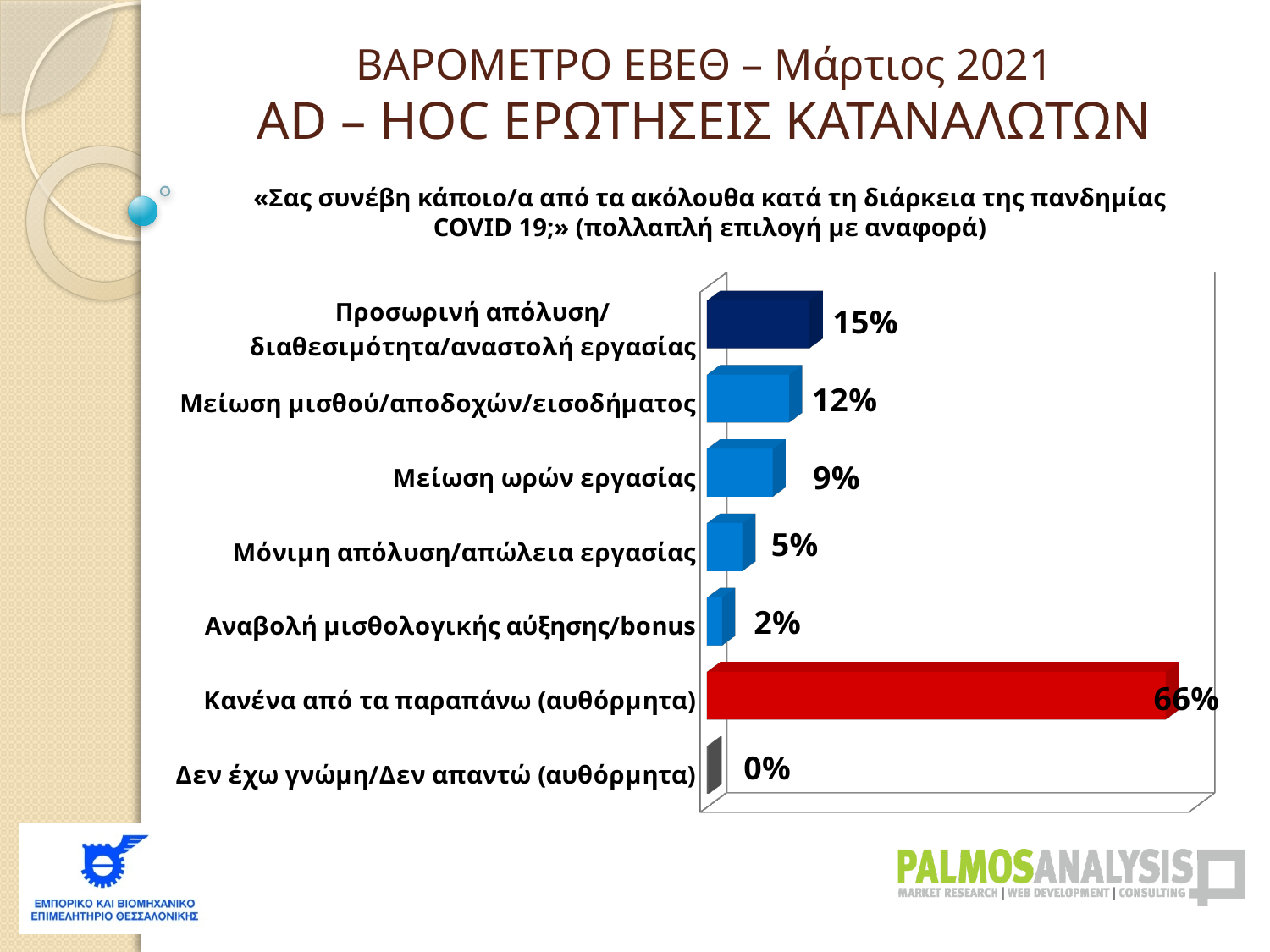
How many categories are shown in the chart? 7 Which category has the lowest value? Δεν έχω γνώμη/Δεν απαντώ (αυθόρμητα) What kind of chart is shown on the slide? Bar chart What is the difference between the values for "Μείωση μισθού/αποδοχών/εισοδήματος" and "Αναβολή μισθολογικής αύξησης/bonus"? 10% What is the difference between the values for "Προσωρινή απόλυση/διαθεσιμότητα/αναστολή εργασίας" and "Μόνιμη απόλυση/απώλεια εργασίας"? 10% What colour is the bar for "Κανένα από τα παραπάνω (αυθόρμητα)"? Red What value is shown for "Μείωση ωρών εργασίας"? 9% Which is larger: the value for "Μείωση ωρών εργασίας" or for "Μόνιμη απόλυση/απώλεια εργασίας"? Μείωση ωρών εργασίας What value is shown for "Αναβολή μισθολογικής αύξησης/bonus"? 2% What percentage is shown for "Κανένα από τα παραπάνω (αυθόρμητα)"? 66% What percentage is shown for "Μείωση μισθού/αποδοχών/εισοδήματος"? 12% Which category has the highest value? Κανένα από τα παραπάνω (αυθόρμητα)